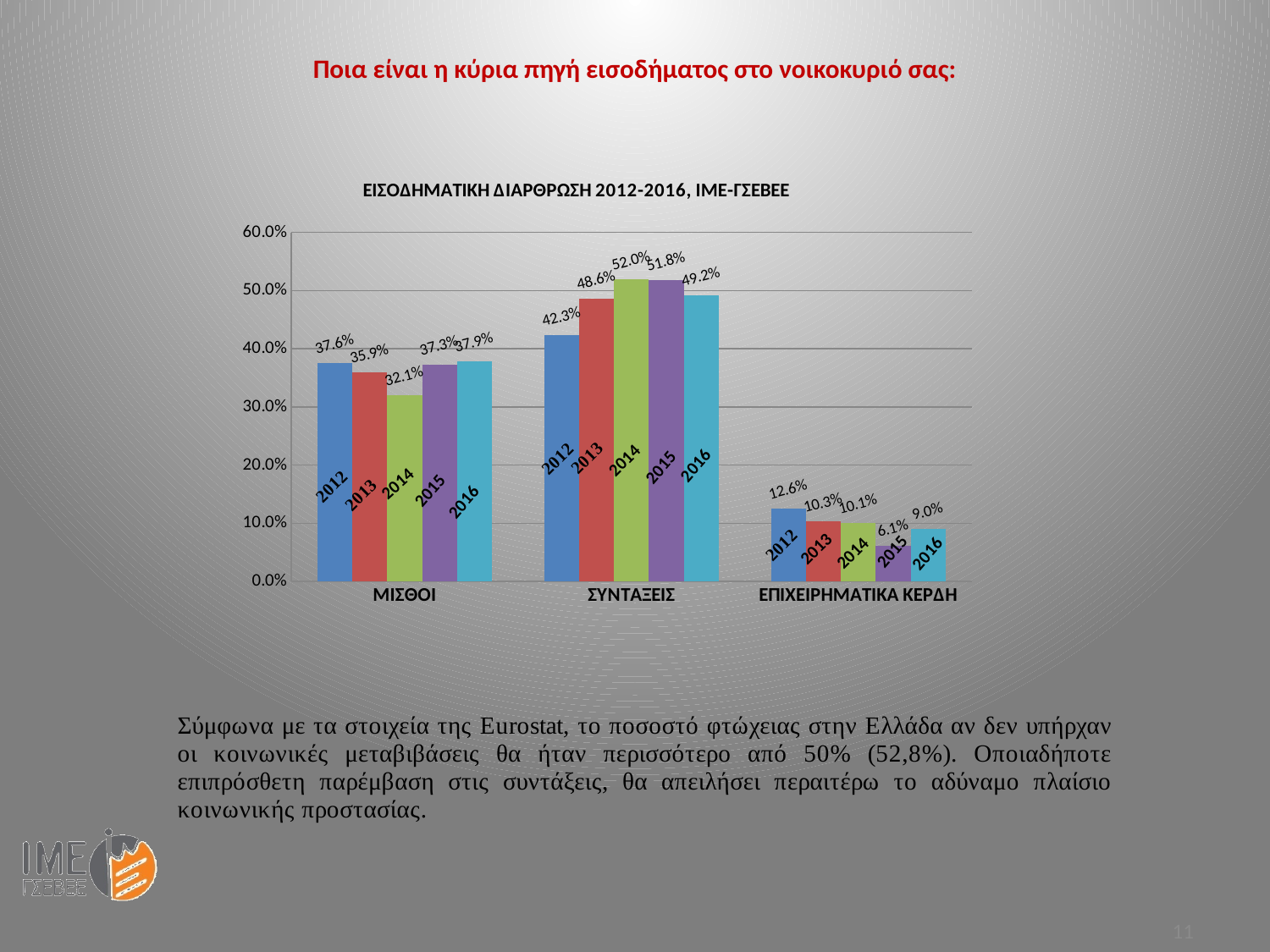
What is the difference between the 2016 and 2012 values for ΣΥΝΤΑΞΕΙΣ? 6.9% What is the value for ΣΥΝΤΑΞΕΙΣ in 2014? 52.0% What is the title of the chart? ΕΙΣΟΔΗΜΑΤΙΚΗ ΔΙΑΡΘΡΩΣΗ 2012-2016, ΙΜΕ-ΓΣΕΒΕΕ How many income categories are shown on the x axis? 3 What is the value for ΜΙΣΘΟΙ in 2012? 37.6% What kind of chart is shown on the slide? bar chart Which year has the lowest value for ΕΠΙΧΕΙΡΗΜΑΤΙΚΑ ΚΕΡΔΗ? 2015 Is the value for ΕΠΙΧΕΙΡΗΜΑΤΙΚΑ ΚΕΡΔΗ in 2012 greater or less than 10.0%? greater Which is larger for 2013: ΜΙΣΘΟΙ or ΣΥΝΤΑΞΕΙΣ? ΣΥΝΤΑΞΕΙΣ What is the value for ΕΠΙΧΕΙΡΗΜΑΤΙΚΑ ΚΕΡΔΗ in 2015? 6.1% Which year has the highest value for ΣΥΝΤΑΞΕΙΣ? 2014 What is the value for ΜΙΣΘΟΙ in 2014? 32.1%